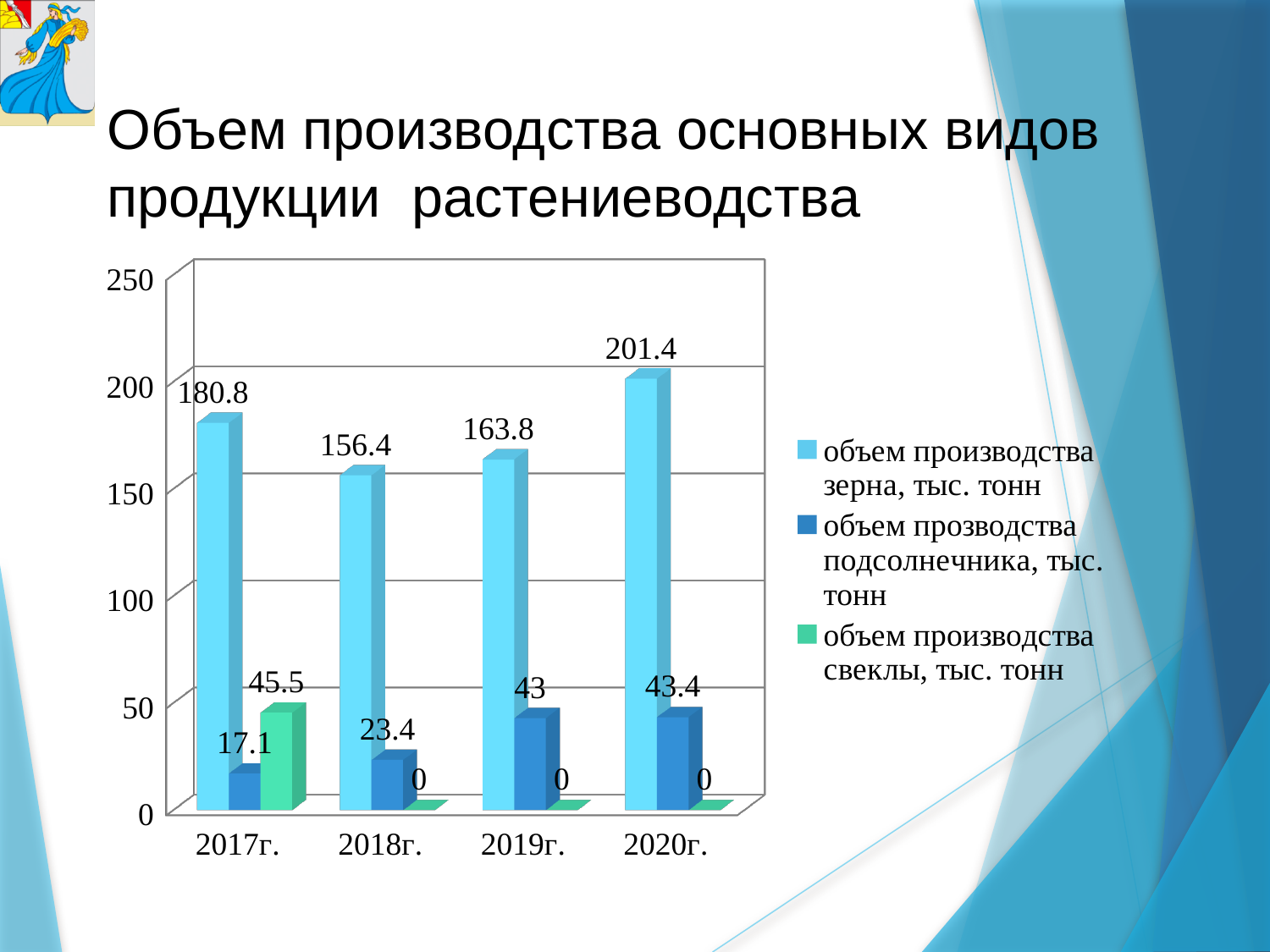
In which year was grain production the lowest? 2018г. By how much did grain production in 2020г. exceed that in 2019г.? 37.6 What was the sugar beet production volume in 2018г., 2019г. and 2020г.? 0 How many years are shown on the x axis? 4 In which year was grain production the highest? 2020г. Which was larger in 2017г.: sunflower production or sugar beet production? sugar beet production (45.5) How many series does the legend list? 3 What was the grain production volume (объем производства зерна) in 2020г.? 201.4 Is the grain production value for 2017г. greater or less than 150? greater What was the sugar beet production volume (объем производства свеклы) in 2017г.? 45.5 What was the sunflower production volume (объем прозводства подсолнечника) in 2018г.? 23.4 What kind of chart is shown on the slide? bar chart